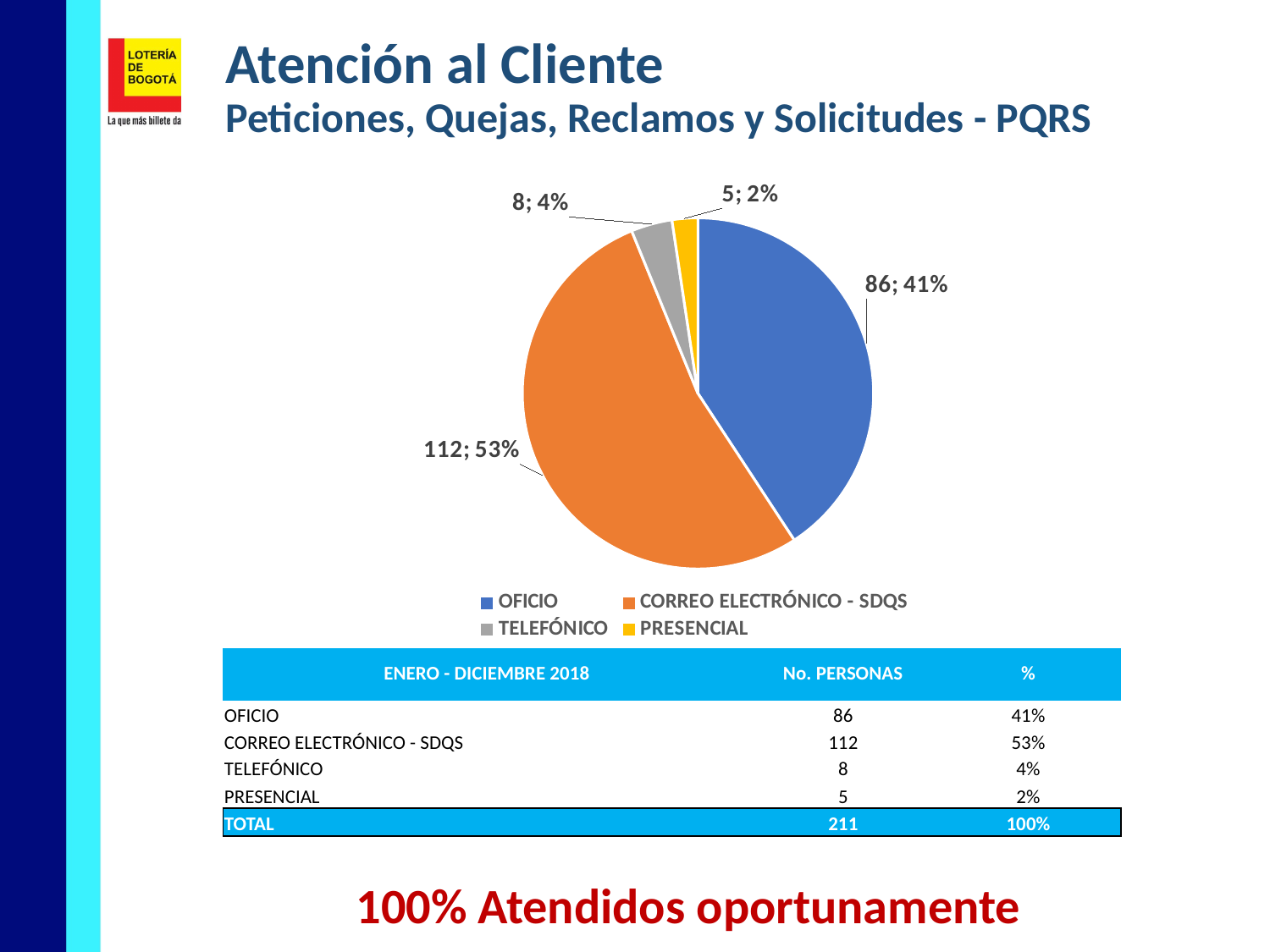
How many entries does the legend of the pie chart list? 4 What is the value shown for TELEFÓNICO in the pie chart? 8 What is the number of persons for CORREO ELECTRÓNICO - SDQS in the pie chart? 112 Which category has the smallest slice in the pie chart? PRESENCIAL What kind of chart is shown on the slide? pie chart How many slices does the pie chart have? 4 What colour is the OFICIO slice in the pie chart? blue Which is larger in the pie chart, TELEFÓNICO or PRESENCIAL? TELEFÓNICO What percentage share does OFICIO have in the pie chart? 41% What percentage share does PRESENCIAL have in the pie chart? 2% Which category has the largest slice in the pie chart? CORREO ELECTRÓNICO - SDQS What is the difference in number of persons between CORREO ELECTRÓNICO - SDQS and OFICIO? 26